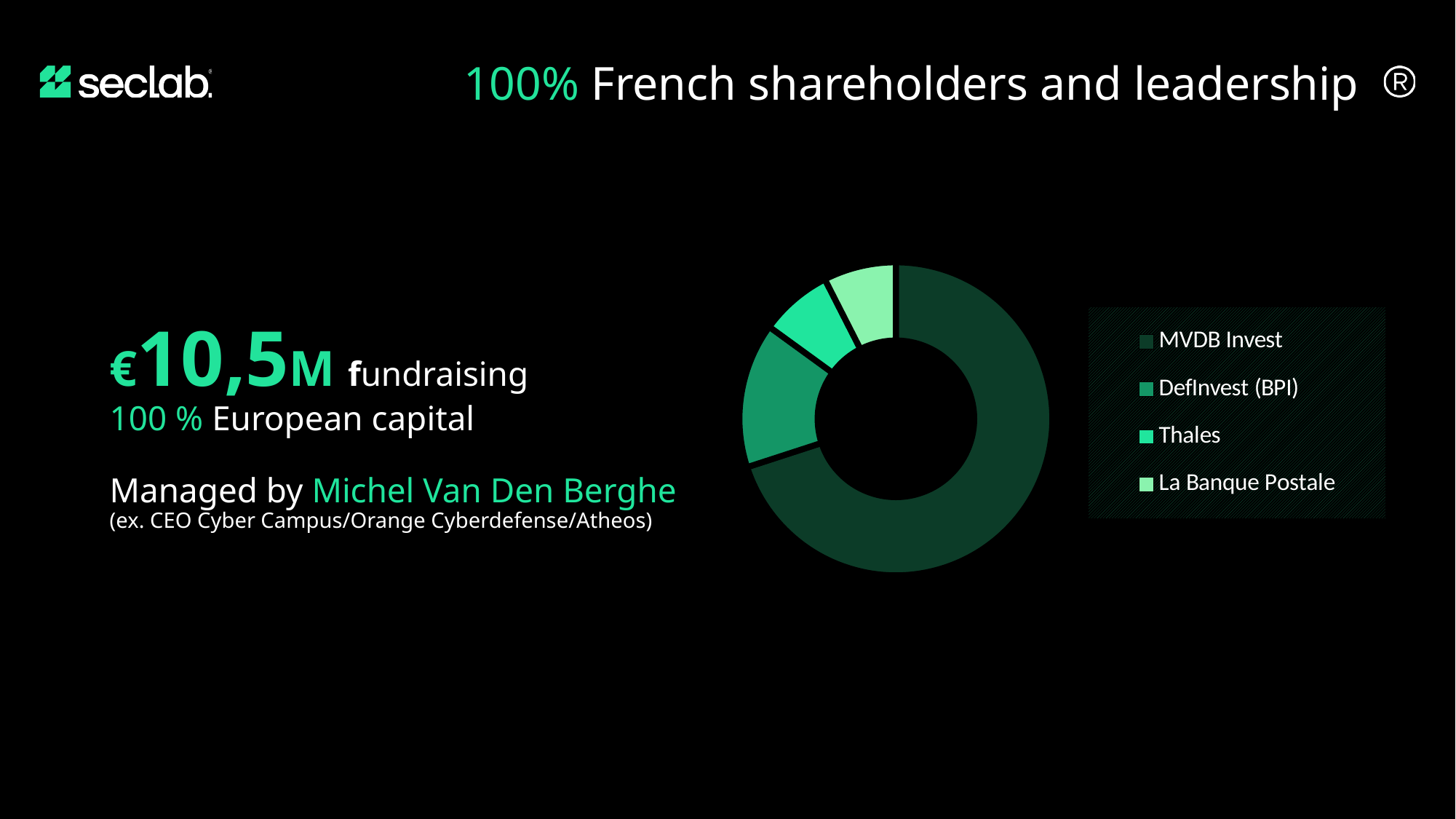
Which shareholder has the largest slice of the donut chart? MVDB Invest Which shareholders are listed in the chart legend? MVDB Invest, DefInvest (BPI), Thales, La Banque Postale Does the MVDB Invest slice make up more or less than half of the donut chart? more Which slice is larger, DefInvest (BPI) or Thales? DefInvest (BPI) Which shareholder is represented by the lightest green slice? La Banque Postale What kind of chart is shown on the slide? donut (pie) chart Which slice is larger, MVDB Invest or DefInvest (BPI)? MVDB Invest Which slice is larger, DefInvest (BPI) or La Banque Postale? DefInvest (BPI) How many shareholder slices does the donut chart have? 4